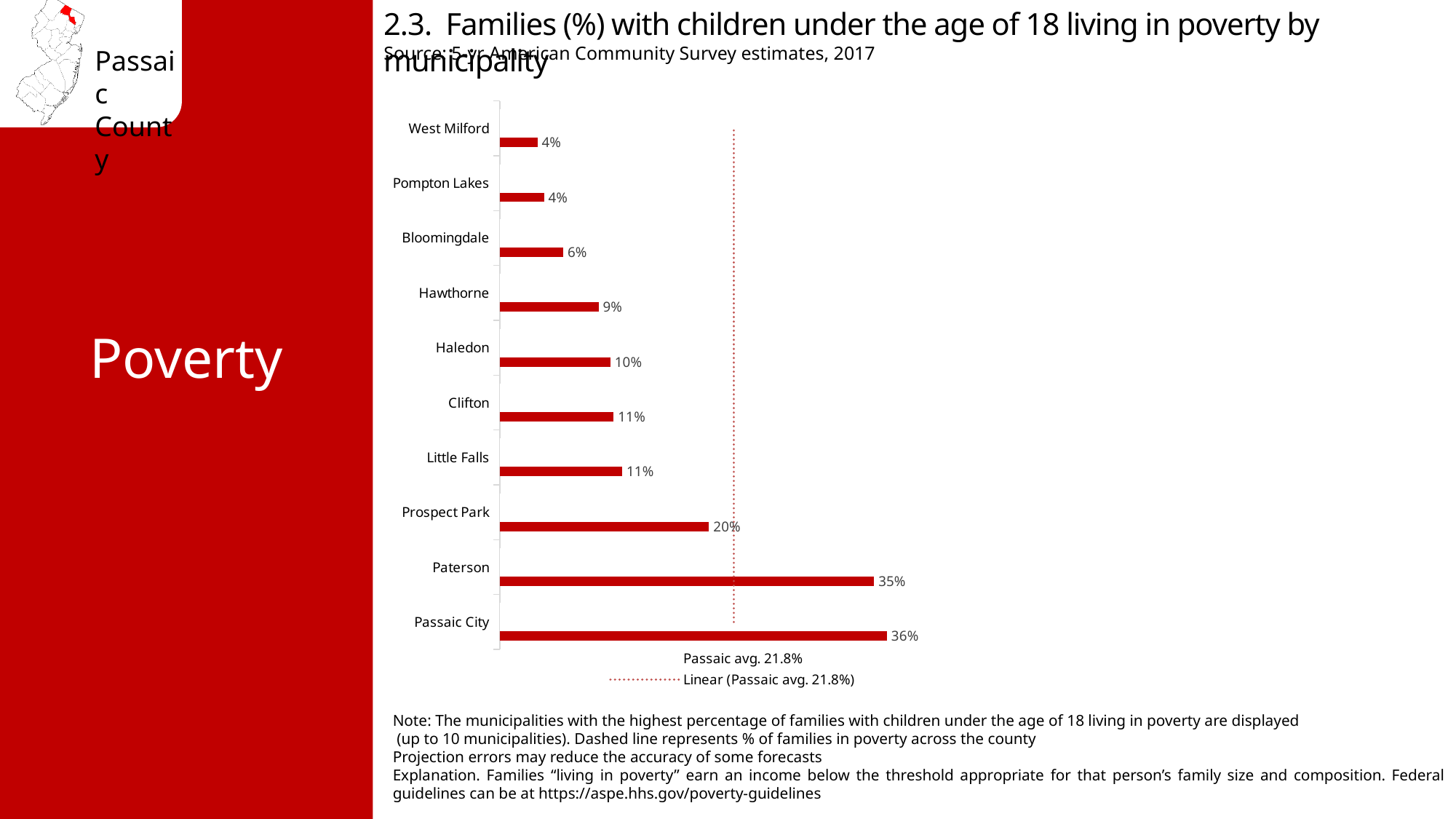
What is the value shown for Prospect Park? 20% What kind of chart is used on this slide? bar chart What is the difference between the values for Clifton and West Milford? 7% Is the value for Paterson greater or less than the Passaic average of 21.8%? greater How many municipalities are shown on the chart? 10 How many entries does the chart legend list? 2 What percentage of families with children under 18 live in poverty in Paterson? 35% What county average value is marked by the dashed line on the chart? 21.8% What is the difference between the values for Passaic City and Prospect Park? 16% Which municipality has the lowest value on the chart, Bloomingdale or Haledon? Bloomingdale Which municipality has the highest percentage of families with children under 18 living in poverty? Passaic City What is the value shown for Hawthorne? 9%